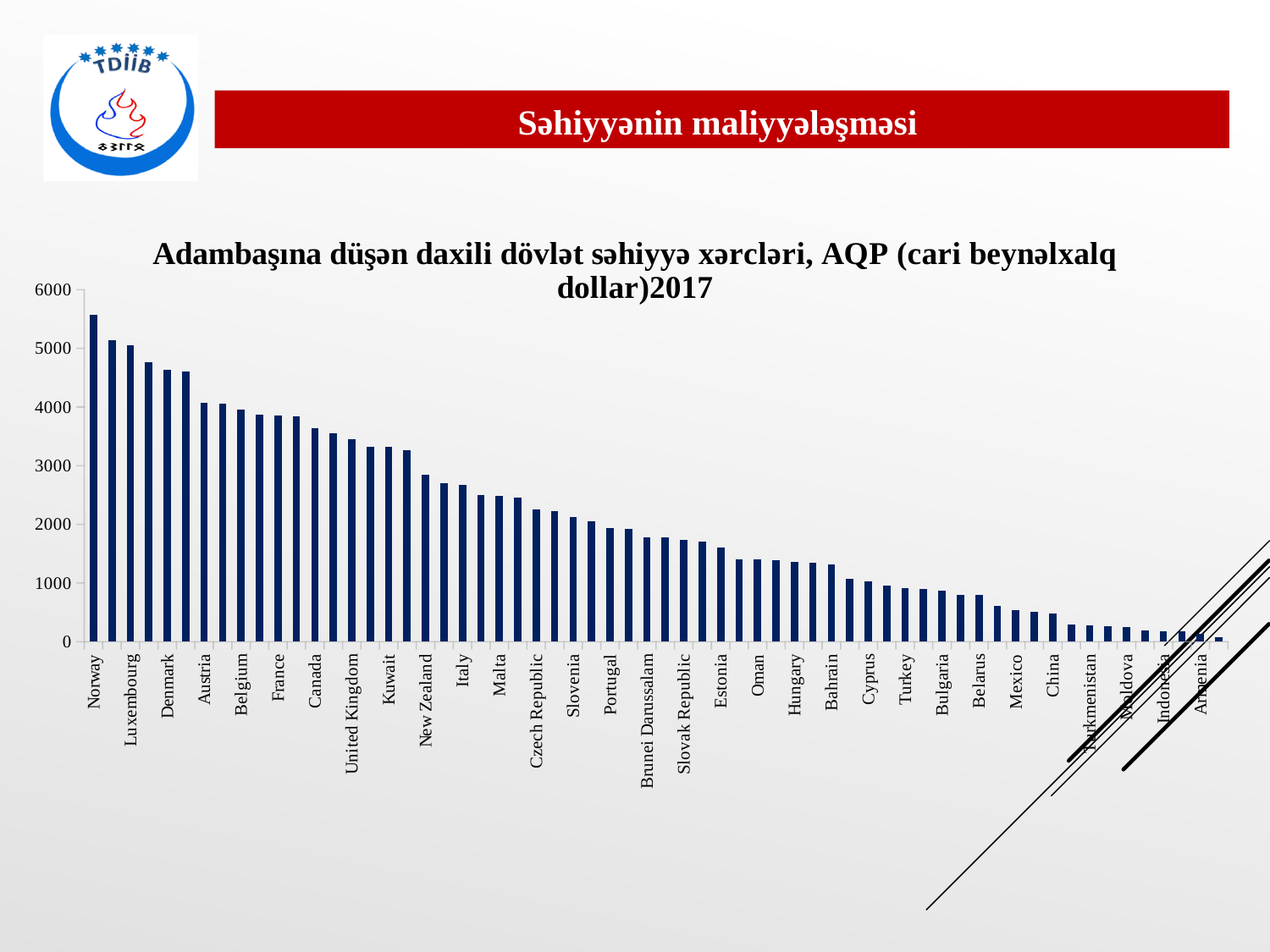
Is the value for Norway greater or less than 5000? greater Do the values generally rise or fall from left to right along the x axis? fall Is the value for Portugal greater or less than 2000? less Which has the larger value, Canada or Kuwait? Canada Is the value for Denmark greater or less than 4000? greater What kind of chart is shown on the slide? bar chart Which country has the highest value in the chart? Norway Which year does the chart title refer to? 2017 Which has the larger value, Norway or Luxembourg? Norway